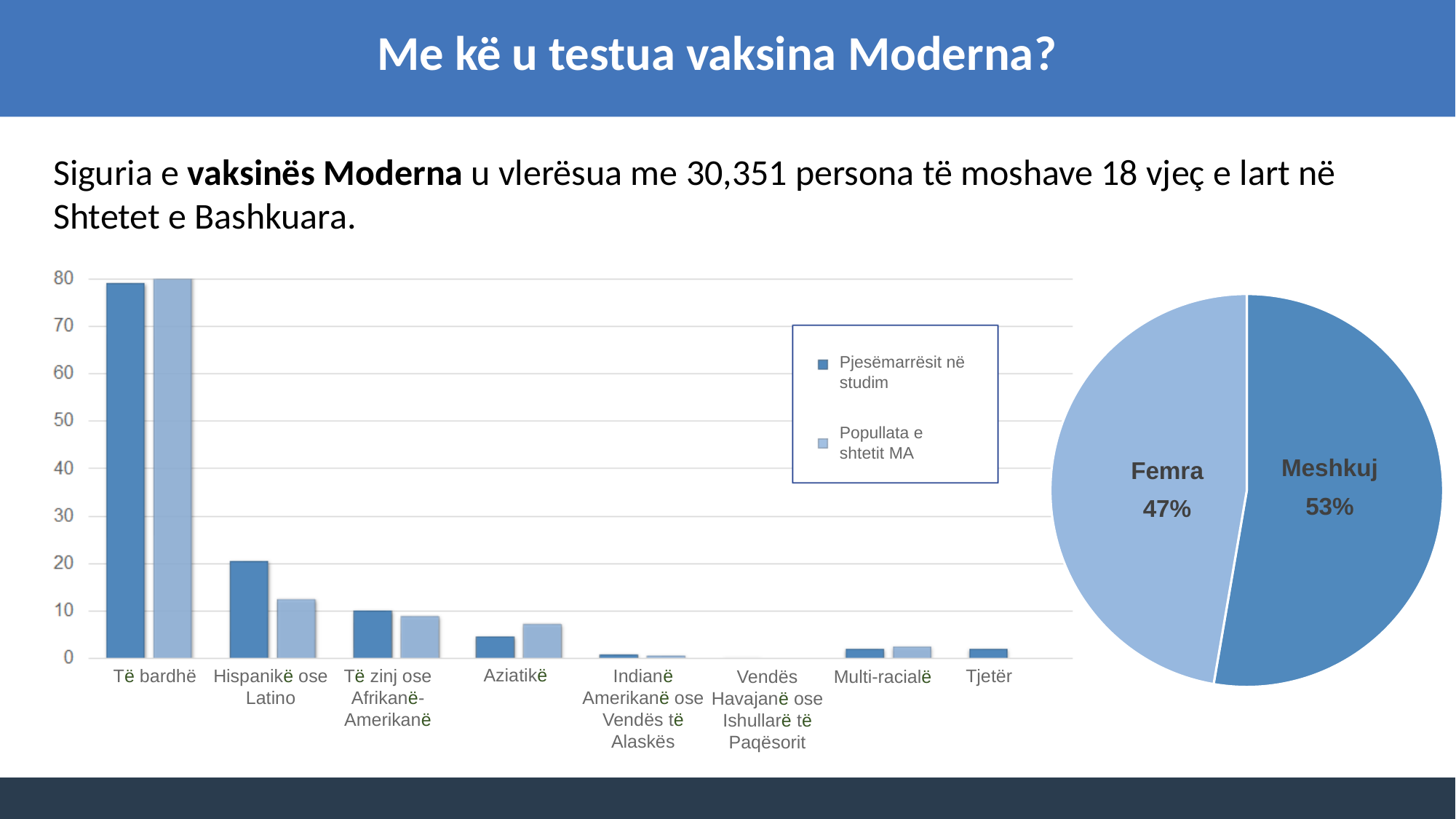
On the pie chart, how many slices are there? 2 What kind of chart is the chart on the left of the slide? bar chart What kind of chart is the chart on the right of the slide? pie chart On the bar chart, how many categories are shown on the x axis? 8 On the pie chart, what share is labelled for Femra? 47% On the pie chart, which slice is larger, Femra or Meshkuj? Meshkuj On the bar chart, how many series does the legend list? 2 On the pie chart, what is the difference in percentage points between Meshkuj and Femra? 6 On the bar chart, which category has the highest value for Pjesëmarrësit në studim? Të bardhë On the bar chart, which is larger for Hispanikë ose Latino, Pjesëmarrësit në studim or Popullata e shtetit MA? Pjesëmarrësit në studim On the bar chart, is the value for Hispanikë ose Latino in the Pjesëmarrësit në studim series greater or less than 10? greater On the pie chart, what share is labelled for Meshkuj? 53%